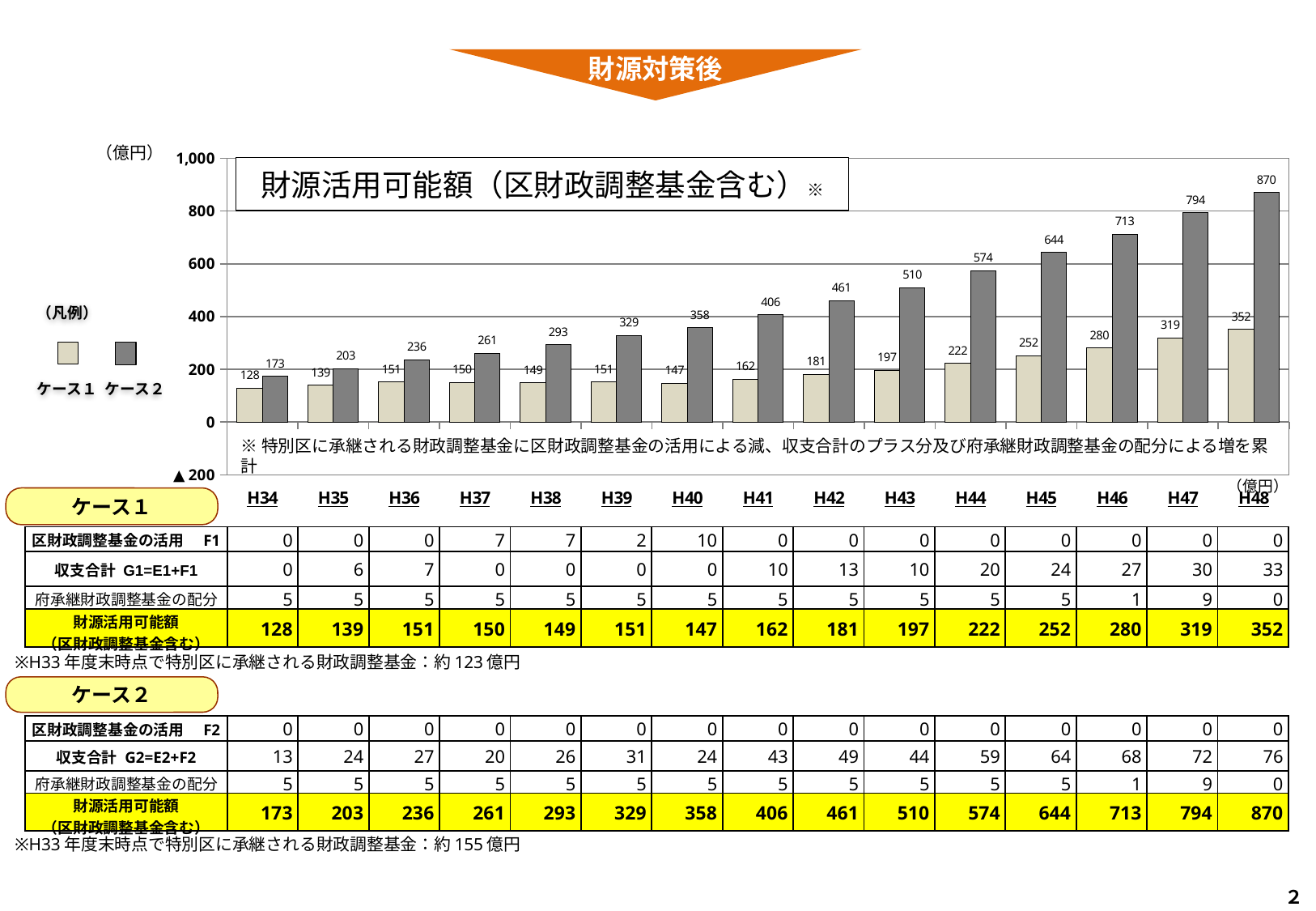
In which year is the ケース2 value highest? H48 Does the ケース2 value rise or fall from H34 to H48? rise Which is larger in H40: ケース1 or ケース2? ケース2 What is the value for ケース1 in H34? 128 What kind of chart is shown? bar chart In which year is the ケース1 value lowest? H34 How many years (categories) are shown on the x axis? 15 What is the value for ケース2 in H41? 406 What is the value for ケース2 in H48? 870 How many series does the legend list? 2 What is the difference between ケース2 and ケース1 in H48? 742 What is the value for ケース1 in H45? 252